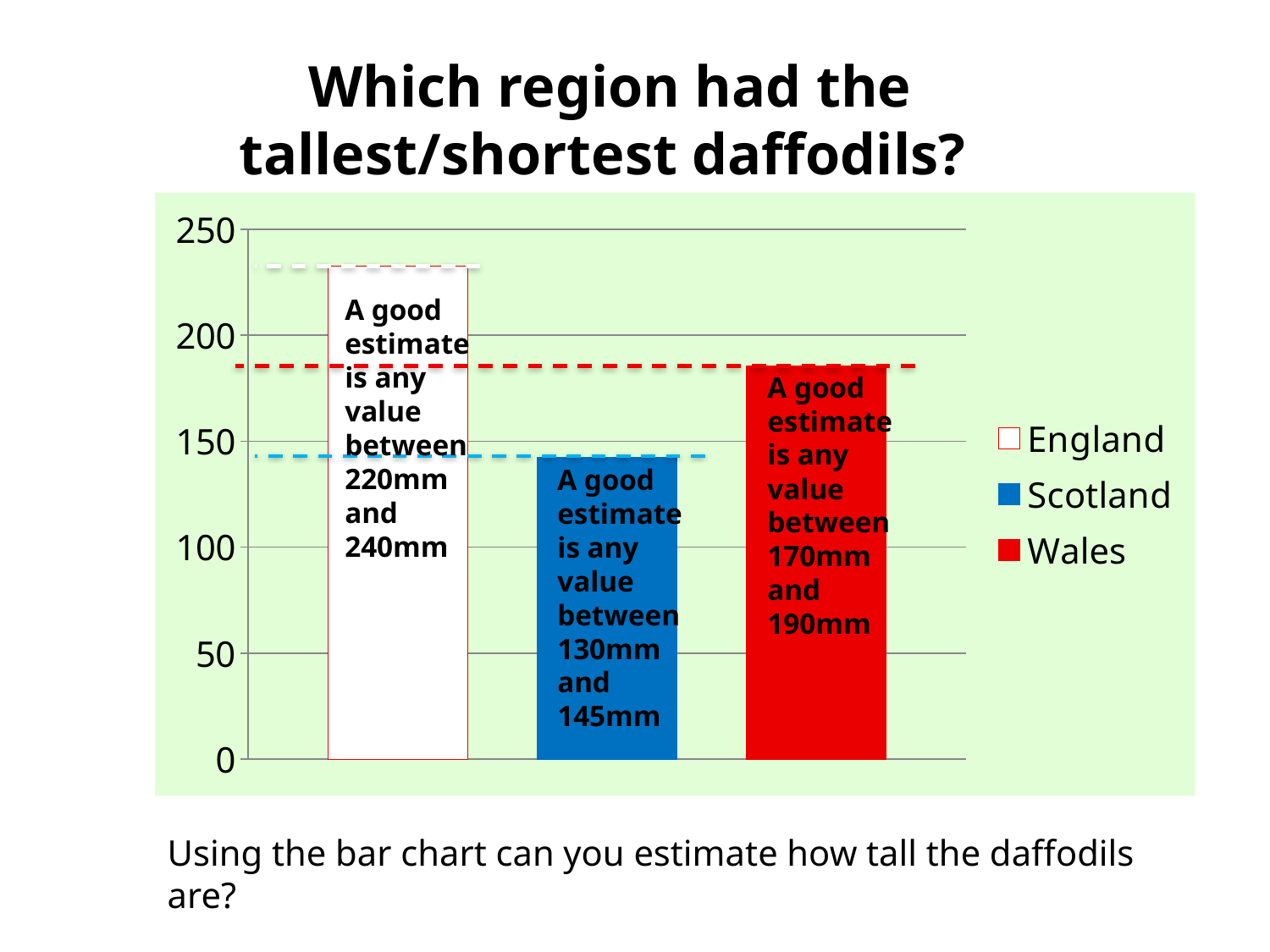
How many bars are plotted in the chart? 3 What colour is the bar for Scotland? blue Is the value for Wales greater or less than 150? greater Is the value for Scotland greater or less than 150? less Which region has the tallest bar in the chart? England Which region has the shortest bar in the chart? Scotland Which bar is taller, England or Wales? England How many entries does the legend list? 3 Which bar is taller, Wales or Scotland? Wales What type of chart is shown on the slide? bar chart Is the value for Wales greater or less than 200? less